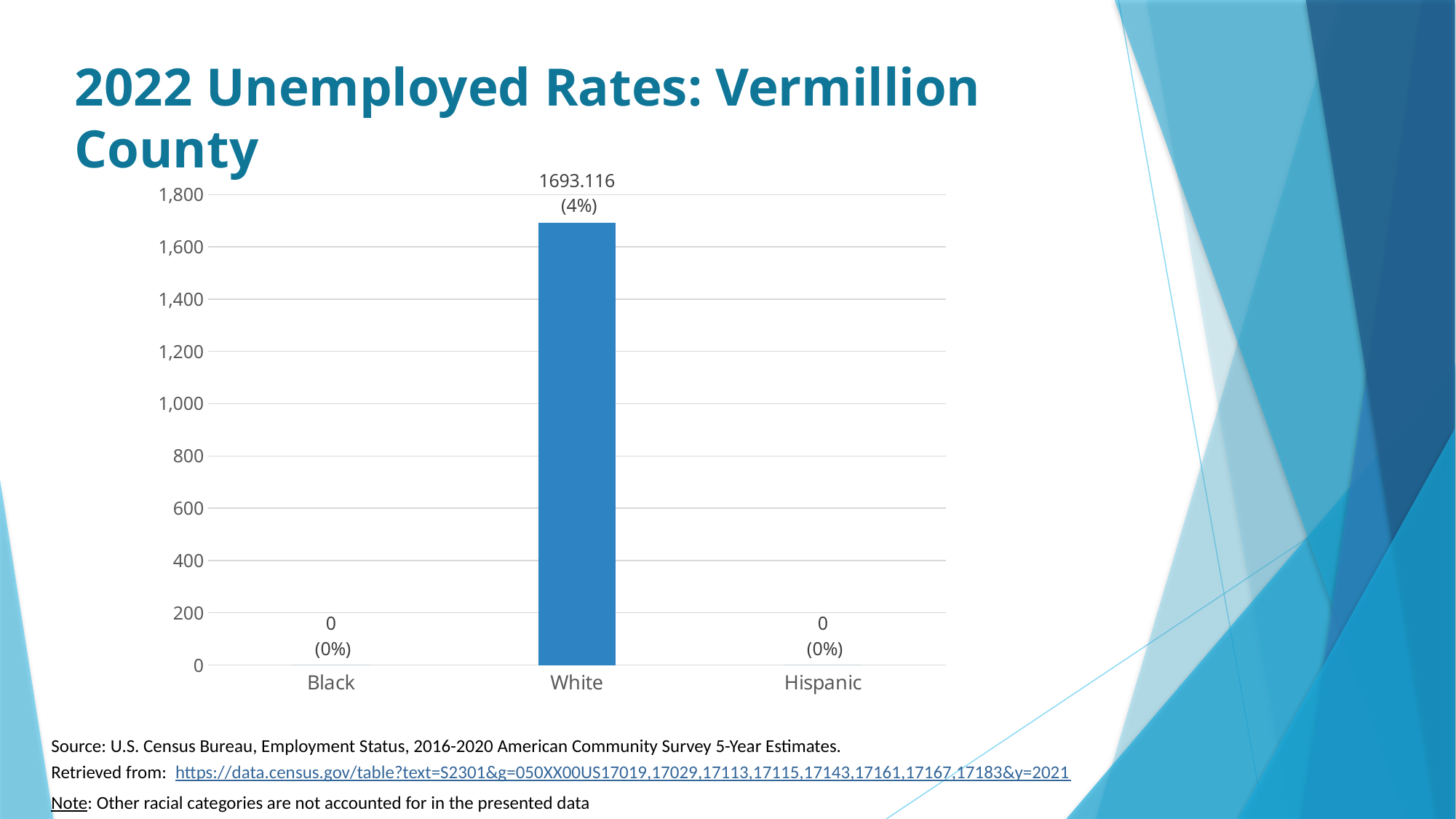
What is the highest value labelled on the y axis? 1,800 How many categories are shown on the x axis? 3 What is the difference between the values for White and Black? 1693.116 What kind of chart is shown on the slide? bar chart Which is larger, the value for White or the value for Hispanic? White What percentage is shown in the data label for White? 4% What is the value shown for Black? 0 Which category has the highest value? White Is the value for White greater or less than 1,600? greater What is the value shown for White? 1693.116 What is the title of the slide? 2022 Unemployed Rates: Vermillion County What is the value shown for Hispanic? 0